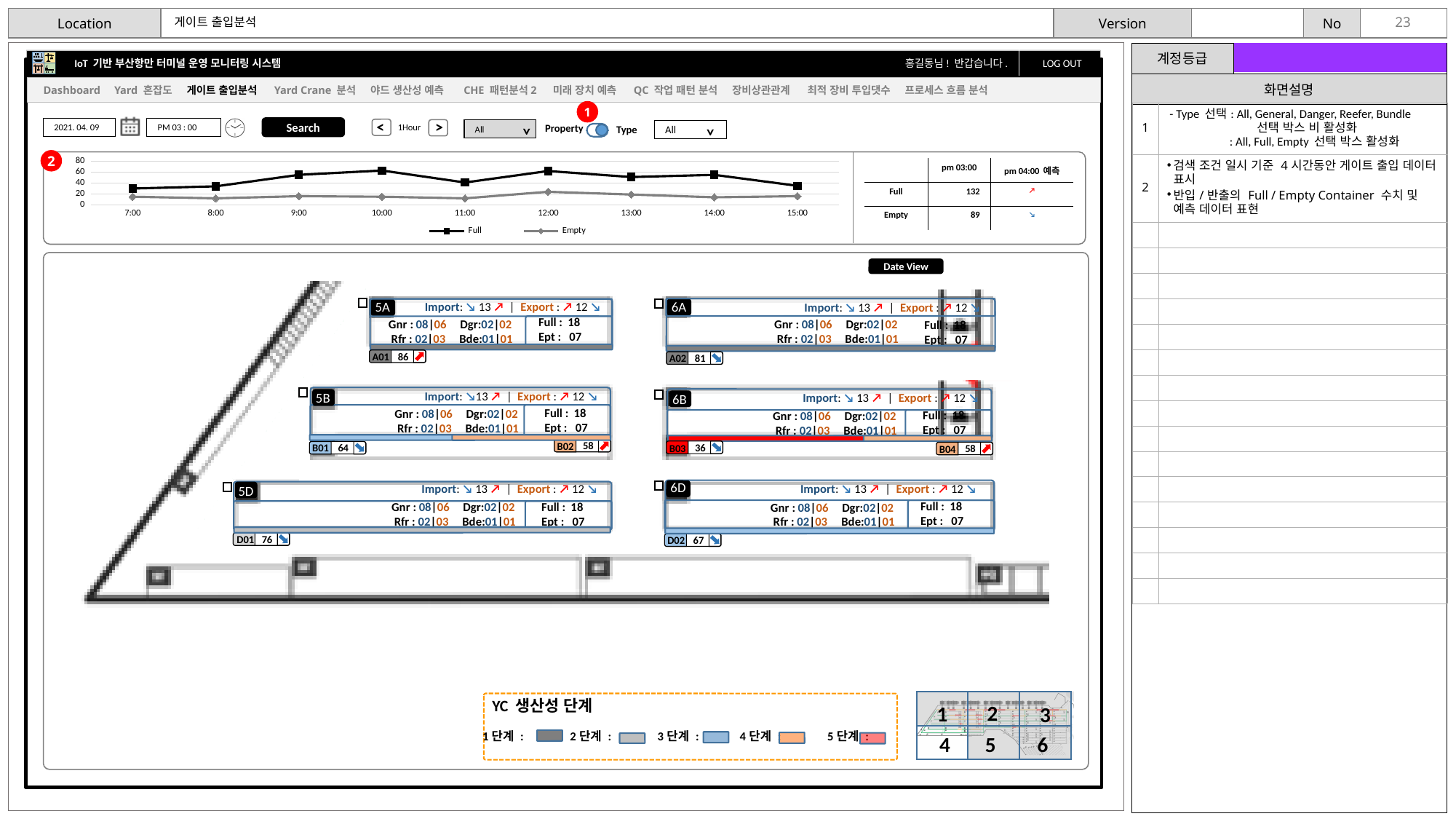
What kind of chart is shown at the top of the screen mock-up? line chart Is the value of the Full series at 7:00 greater or less than 40? less Does the Full series rise or fall from 7:00 to 10:00? rise Is the value of the Full series at 10:00 greater or less than 40? greater At 10:00, which series has the larger value, Full or Empty? Full How many time points are plotted along the x axis of the line chart? 9 For the Full series, which is larger: the value at 10:00 or the value at 11:00? 10:00 Does the Full series rise or fall from 14:00 to 15:00? fall Is the value of the Empty series at 12:00 greater or less than 40? less What are the two series named in the line chart's legend? Full and Empty How many series does the legend of the line chart list? 2